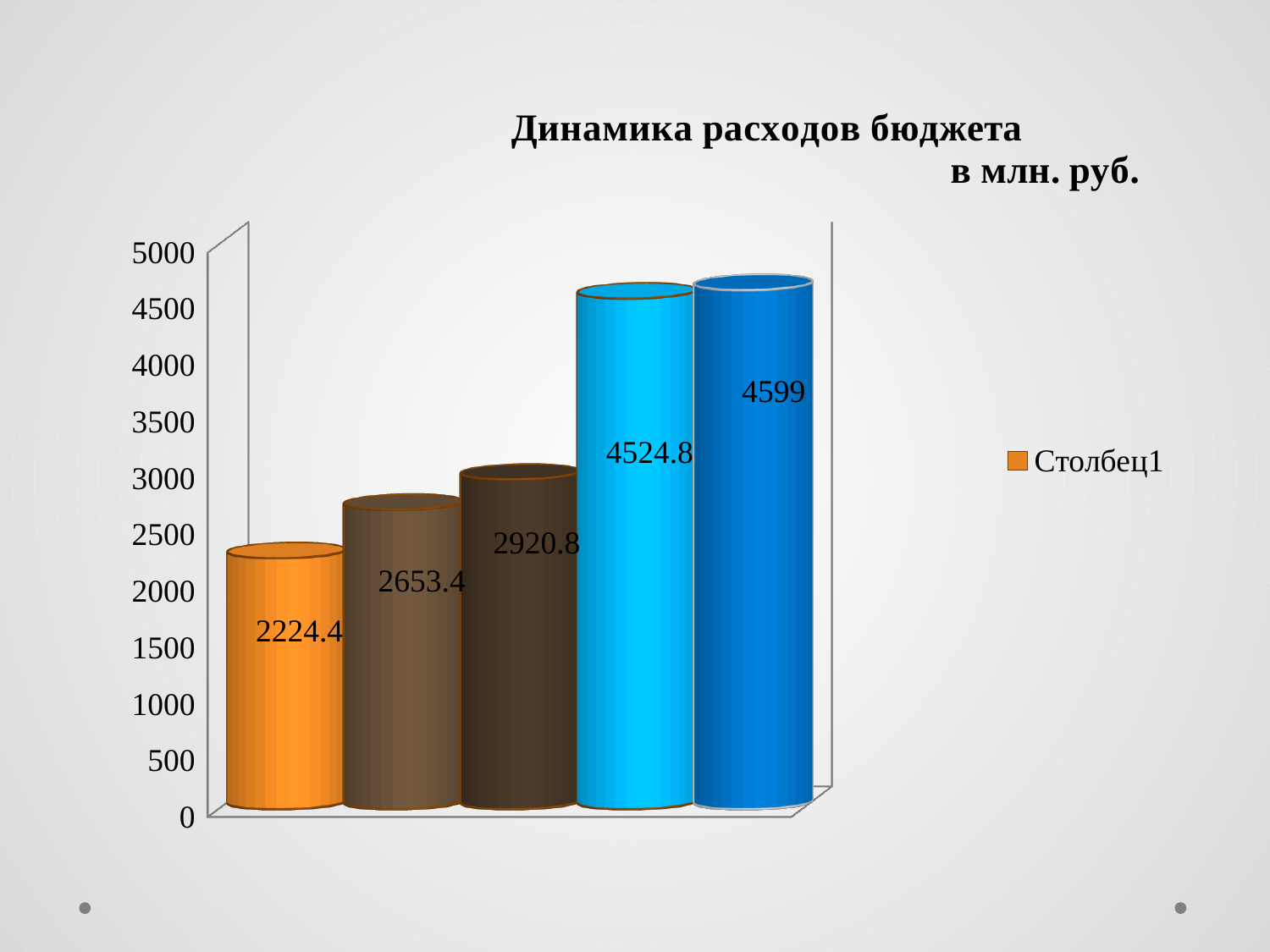
Do the values rise or fall from left to right across the bars? Rise Which is larger, the value of the third bar or the value of the fourth bar? The fourth bar (4524.8) What is the difference between the rightmost bar (4599) and the leftmost bar (2224.4)? 2374.6 What is the value shown on the second bar from the left? 2653.4 What is the value shown on the rightmost (dark blue) bar? 4599 Which bar has the lowest value? The leftmost (orange) bar, 2224.4 What is the value shown on the first (leftmost, orange) bar? 2224.4 How many bars are plotted in the chart? 5 Which bar has the highest value? The rightmost (dark blue) bar, 4599 What is the value shown on the fourth (light blue) bar? 4524.8 What is the value shown on the third (dark brown) bar? 2920.8 What type of chart is shown on the slide? Bar chart